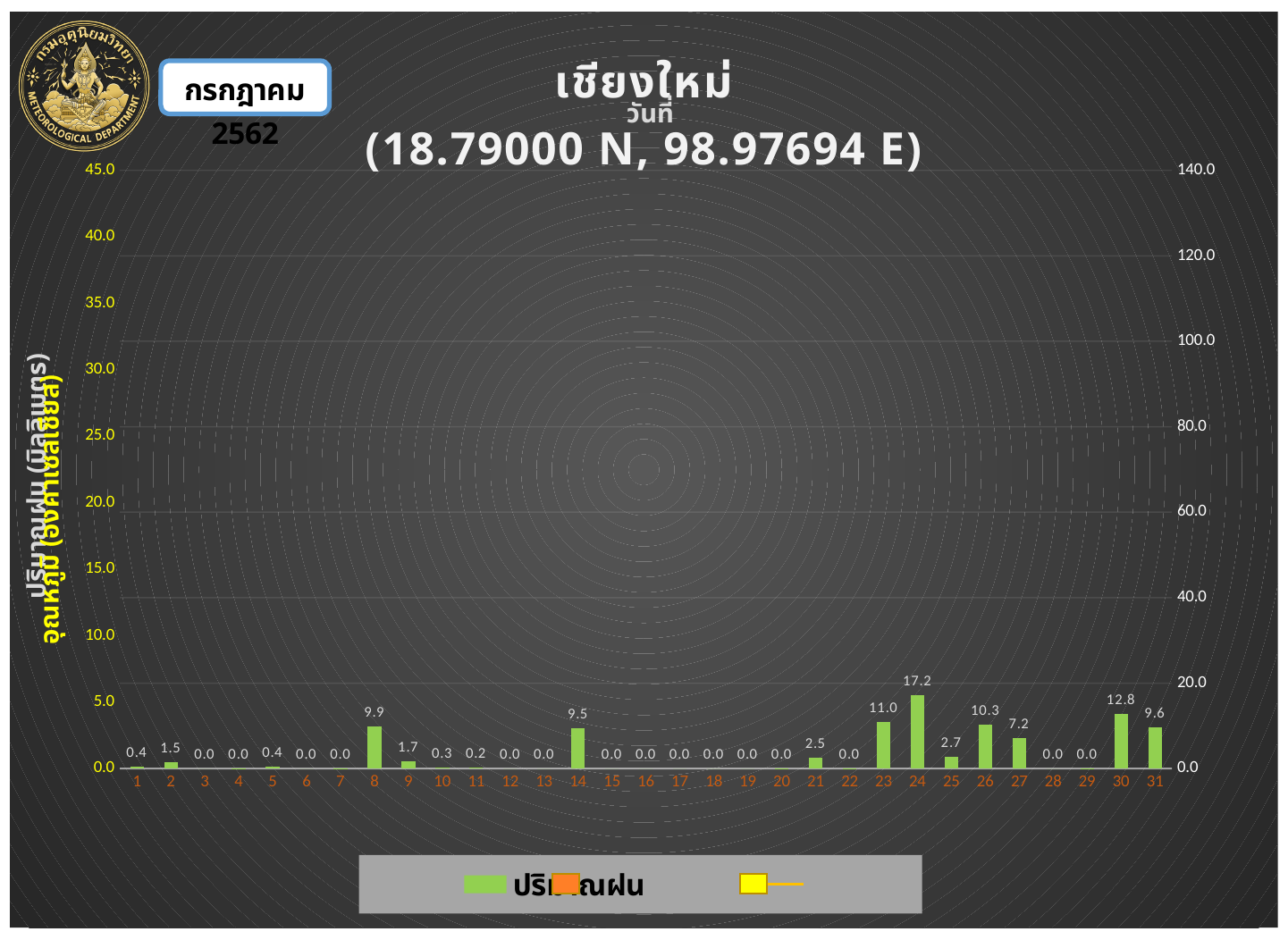
Which is larger, the value for day 26 or the value for day 27? day 26 What is the difference between the values for day 24 and day 23? 6.2 How many days are shown on the x axis? 31 Which is larger, the value for day 14 or the value for day 9? day 14 What is the difference between the values for day 30 and day 31? 3.2 What coordinates are given in the chart title? 18.79000 N, 98.97694 E What is the value for day 24? 17.2 What is the value for day 30? 12.8 Which day has the highest value? 24 What is the value for day 21? 2.5 What kind of chart is shown on the slide? bar chart What is the value for day 8? 9.9